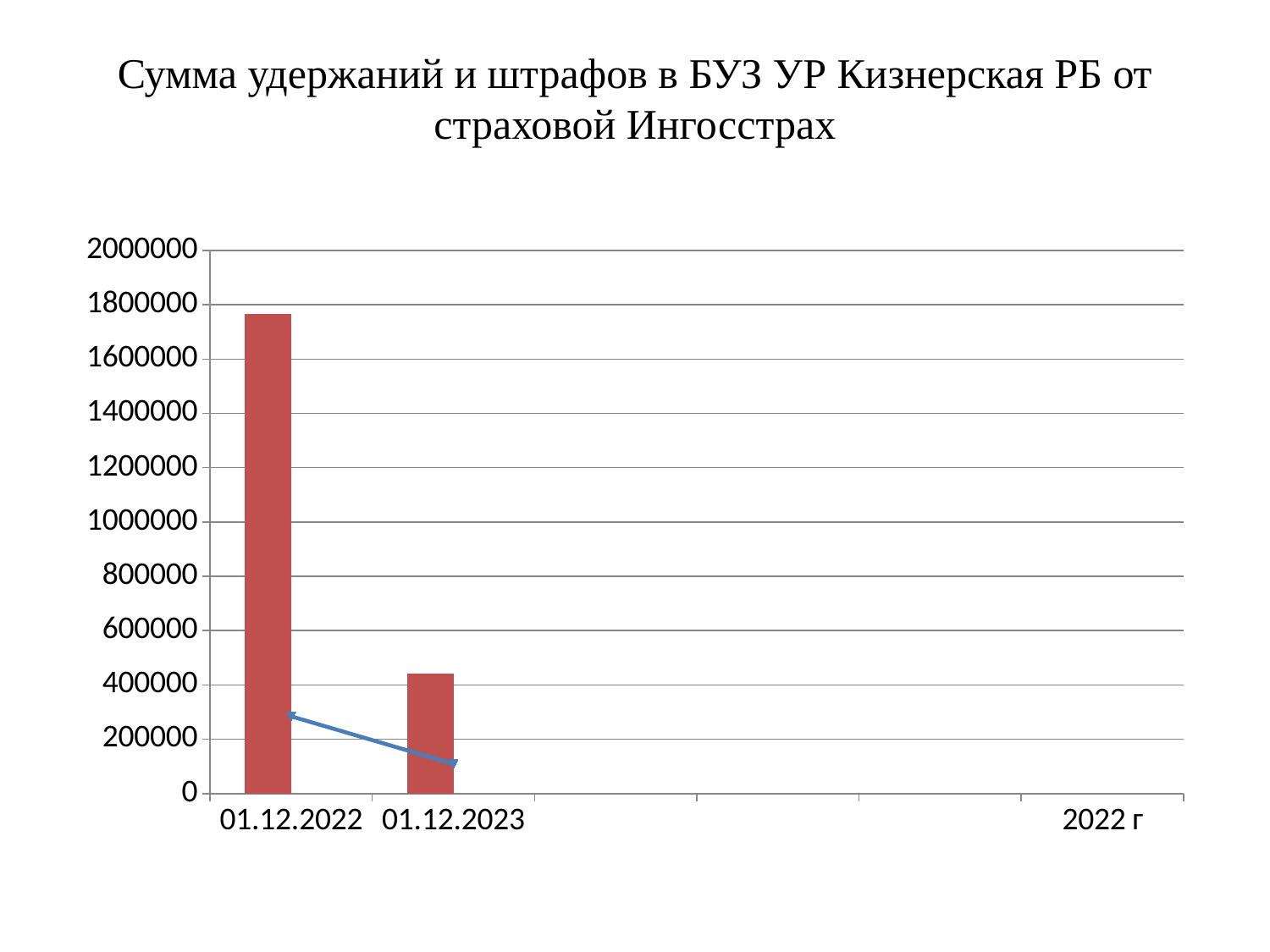
Is the bar for 01.12.2023 greater or less than 1000000? less Is the bar for 01.12.2022 greater or less than 1600000? greater How many bars are plotted on the chart? 2 Is the bar for 01.12.2023 greater or less than 600000? less What kind of chart is shown on the slide? combination bar and line chart Which date has the lowest bar? 01.12.2023 What is the title of the chart? Сумма удержаний и штрафов в БУЗ УР Кизнерская РБ от страховой Ингосстрах Which bar is taller, 01.12.2022 or 01.12.2023? 01.12.2022 Do the bar values rise or fall from 01.12.2022 to 01.12.2023? fall Which date has the highest bar? 01.12.2022